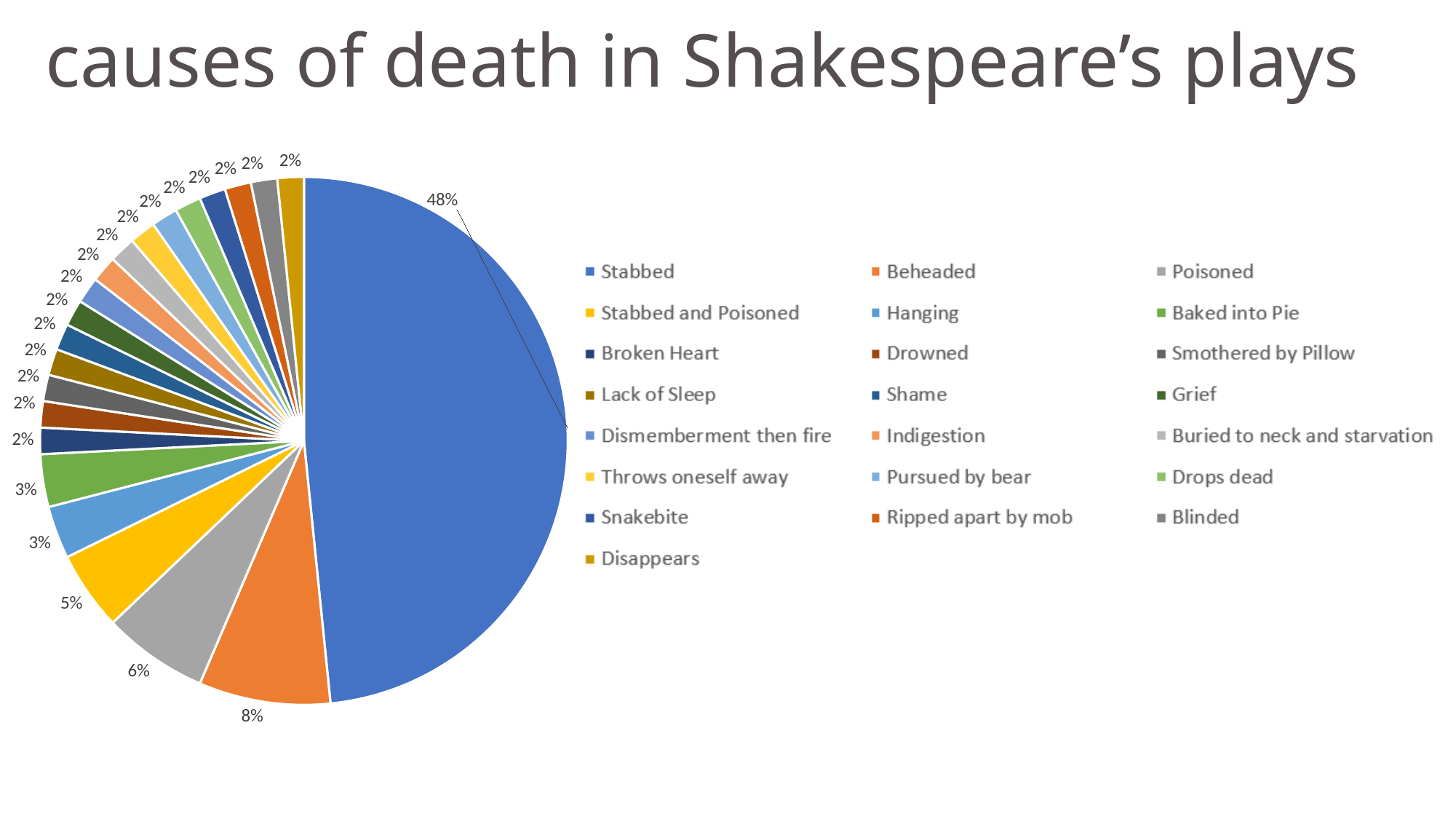
What is the difference in percentage points between Stabbed and Beheaded? 40% What is the title of the chart? causes of death in Shakespeare's plays What percentage of deaths is attributed to Poisoned? 6% Which has a larger share, Beheaded or Poisoned? Beheaded How many causes of death are listed in the legend? 22 What kind of chart is shown on the slide? pie chart What percentage of deaths is attributed to Hanging? 3% What percentage of deaths is attributed to Stabbed? 48% What percentage of deaths is attributed to Beheaded? 8% What colour is the slice for Stabbed? blue Which cause of death has the largest share of the pie? Stabbed What percentage of deaths is attributed to Stabbed and Poisoned? 5%